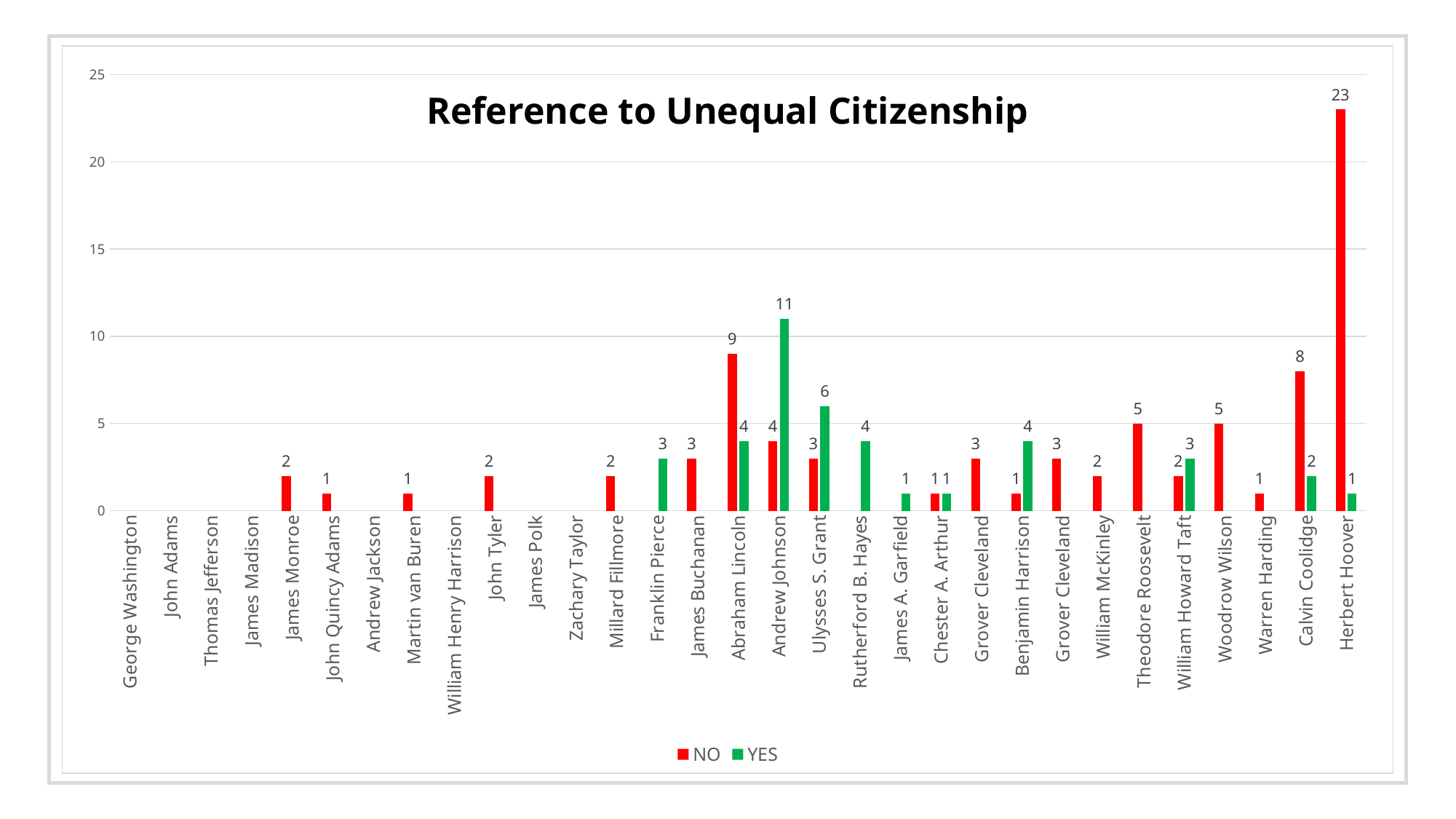
What is the YES value for Andrew Johnson? 11 What is the NO value for Abraham Lincoln? 9 What is the title of the chart? Reference to Unequal Citizenship Which president has the highest NO value? Herbert Hoover What is the YES value for Ulysses S. Grant? 6 How many series does the legend list? 2 Which president has the highest YES value? Andrew Johnson Is the NO value for Herbert Hoover greater or less than 20? greater What kind of chart is shown on the slide? Bar chart What is the NO value for Herbert Hoover? 23 What is the difference between the NO and YES values for Calvin Coolidge? 6 For Andrew Johnson, which is larger, the NO value or the YES value? YES